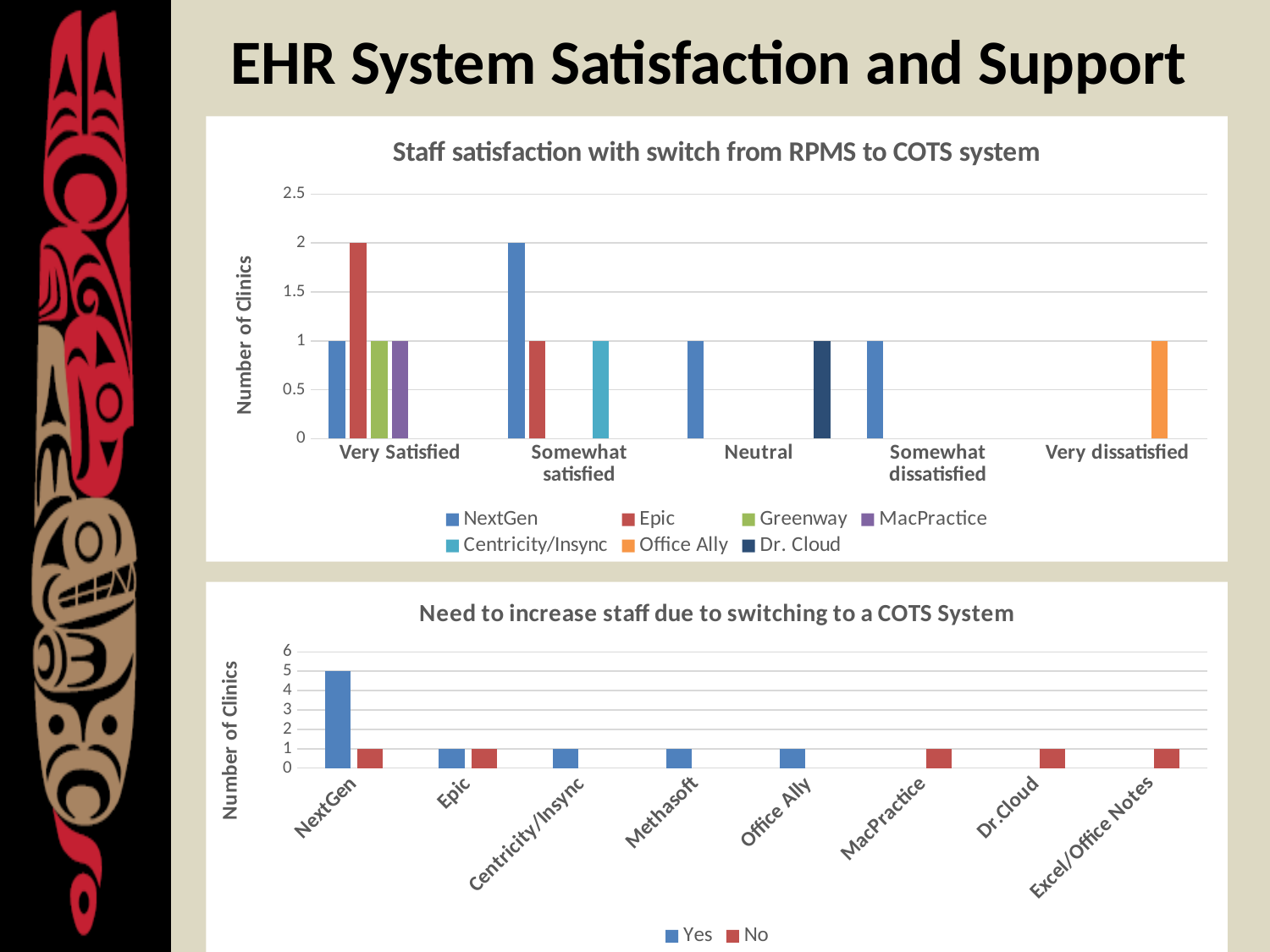
In the 'Need to increase staff due to switching to a COTS System' chart, how many NextGen clinics answered Yes? 5 In the 'Staff satisfaction with switch from RPMS to COTS system' chart, how many satisfaction categories are shown on the x axis? 5 In the 'Need to increase staff due to switching to a COTS System' chart, how many systems are listed on the x axis? 8 In the 'Staff satisfaction with switch from RPMS to COTS system' chart, which is larger: the Epic value for Very Satisfied or the Epic value for Somewhat satisfied? Very Satisfied In the 'Need to increase staff due to switching to a COTS System' chart, which system has the highest Yes value? NextGen In the 'Staff satisfaction with switch from RPMS to COTS system' chart, how many series does the legend list? 7 What kind of chart is the 'Need to increase staff due to switching to a COTS System' chart? Bar chart In the 'Staff satisfaction with switch from RPMS to COTS system' chart, how many clinics using Epic were Very Satisfied? 2 In the 'Need to increase staff due to switching to a COTS System' chart, how many series does the legend list? 2 In the 'Staff satisfaction with switch from RPMS to COTS system' chart, which system is the only one with a bar in the Very dissatisfied category? Office Ally In the 'Staff satisfaction with switch from RPMS to COTS system' chart, how many NextGen clinics were Somewhat satisfied? 2 In the 'Need to increase staff due to switching to a COTS System' chart, what is the difference between the Yes and No values for NextGen? 4